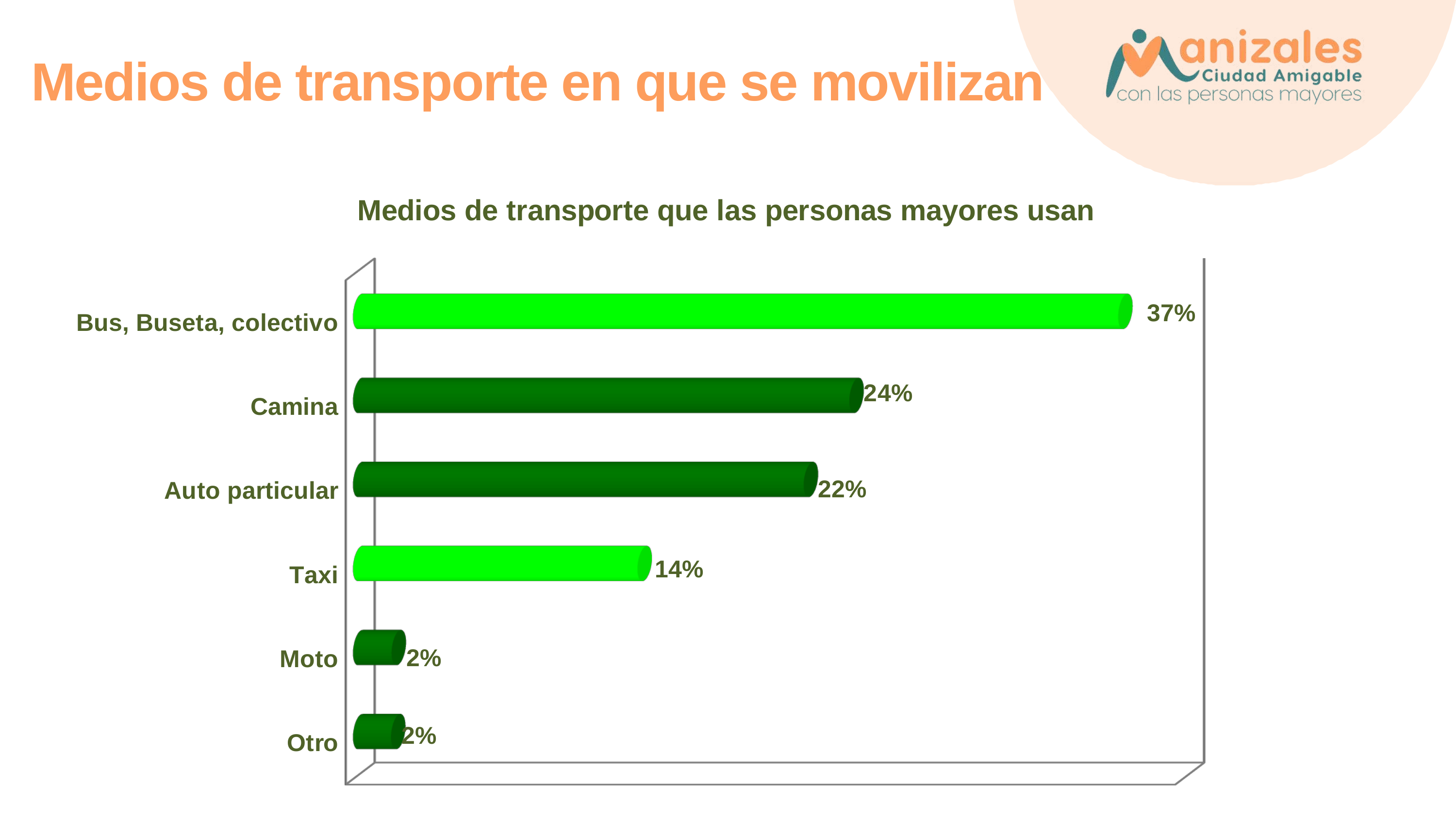
Which is larger, the value for Camina or the value for Taxi? Camina How many means of transport categories are shown in the chart? 6 What is the value shown for Taxi? 14% What is the difference between the values for Bus, Buseta, colectivo and Camina? 13% What is the value shown for Moto? 2% What is the value shown for Camina? 24% What percentage of older adults use Bus, Buseta, colectivo? 37% What kind of chart is shown on the slide? Bar chart What is the difference between the values for Auto particular and Taxi? 8% What is the value shown for Auto particular? 22% What is the title of the chart? Medios de transporte que las personas mayores usan Which means of transport has the highest value? Bus, Buseta, colectivo